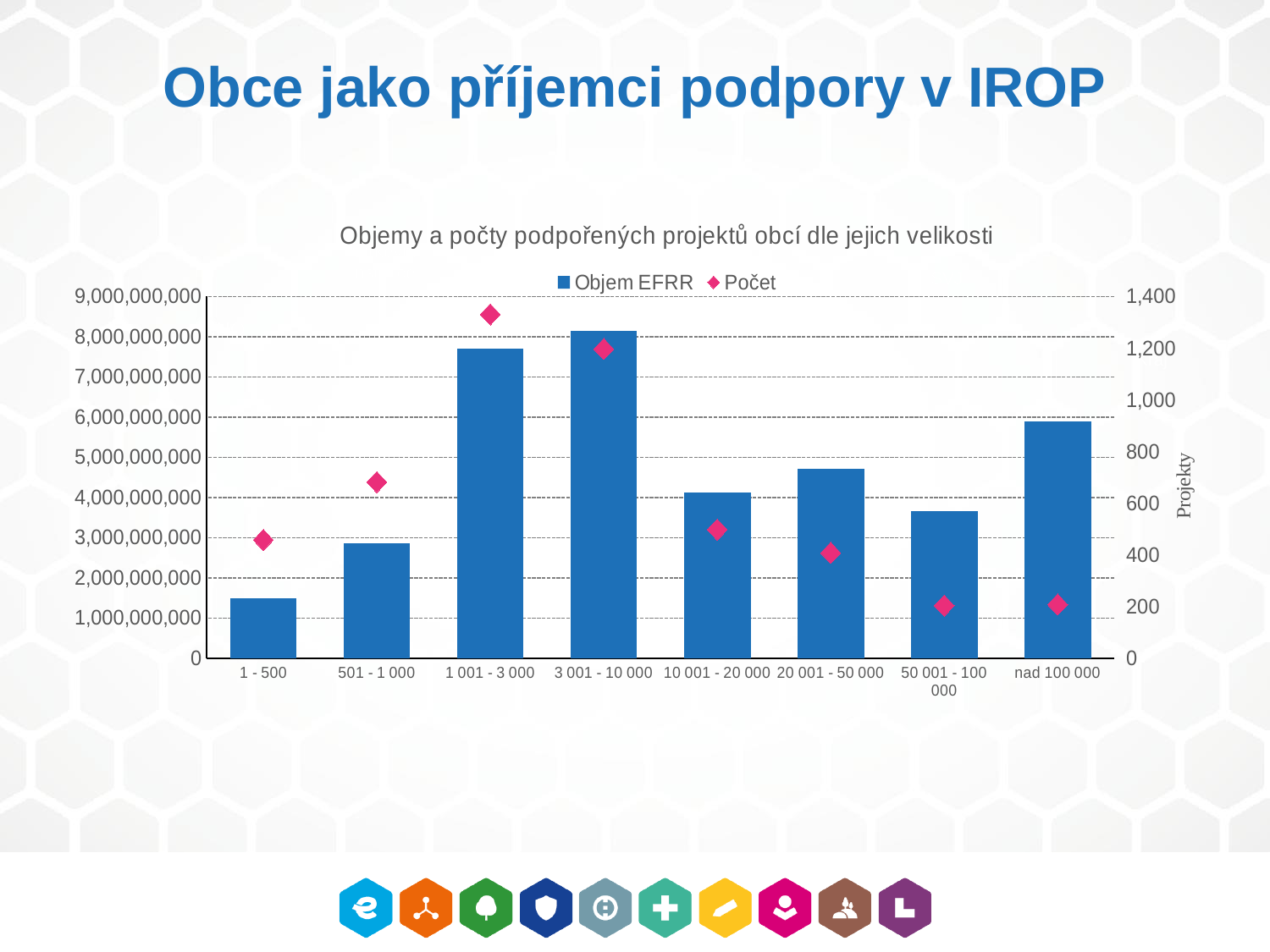
Is the Objem EFRR value for nad 100 000 greater or less than 5,000,000,000? greater How many municipality size categories are shown on the x axis? 8 What is the title of the chart? Objemy a počty podpořených projektů obcí dle jejich velikosti How many series does the chart legend list? 2 Which has the larger Objem EFRR bar: 1 001 - 3 000 or 10 001 - 20 000? 1 001 - 3 000 Which category has the lowest Objem EFRR bar? 1 - 500 Is the Počet value for 1 001 - 3 000 greater or less than 1,200? greater Is the Objem EFRR value for 1 - 500 greater or less than 2,000,000,000? less Which category has the highest Počet marker? 1 001 - 3 000 What label is shown on the right-hand vertical axis? Projekty Which category has the highest Objem EFRR bar? 3 001 - 10 000